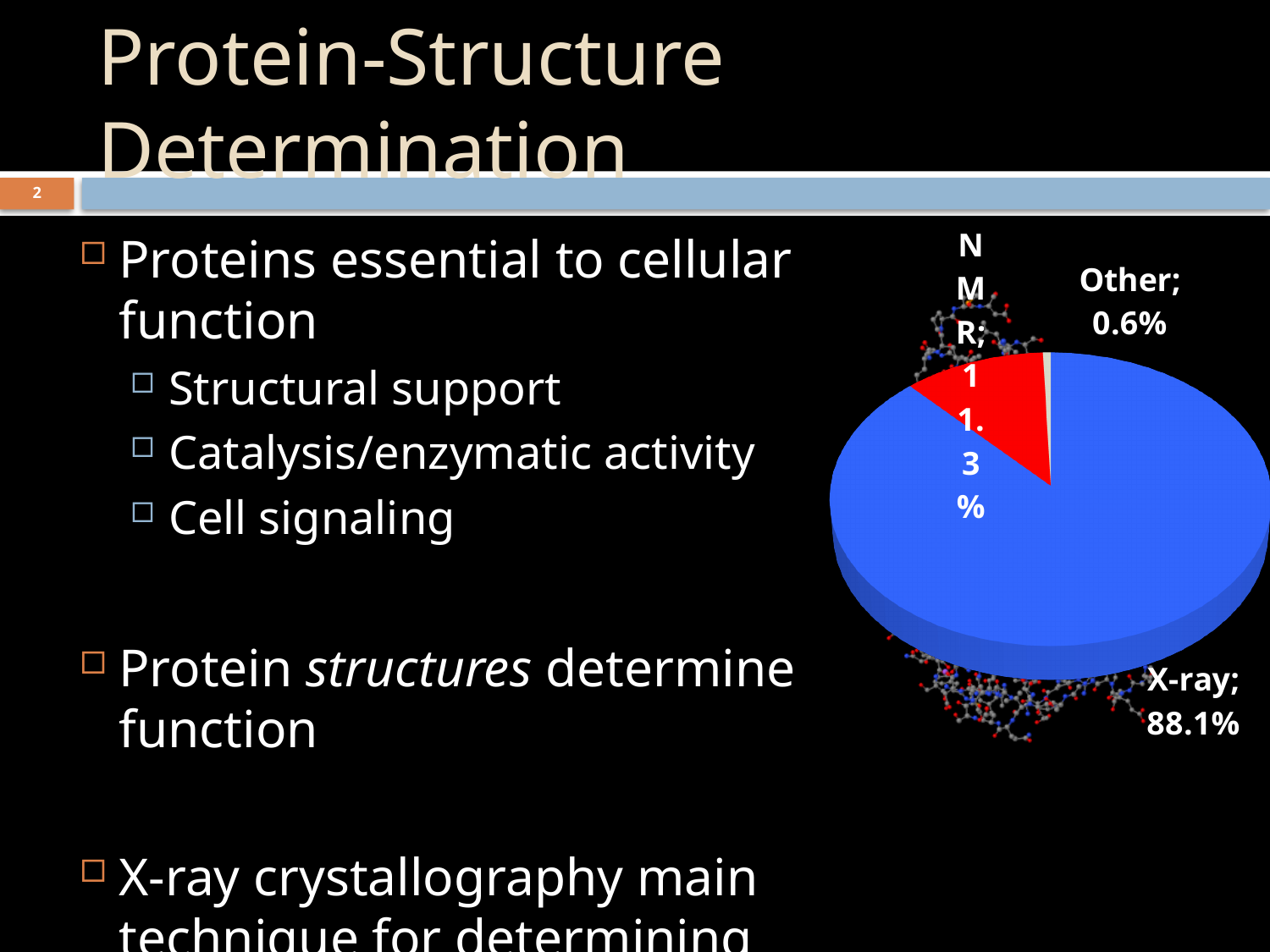
What is the difference in percentage points between the NMR and Other slices? 10.7 Which category has the smallest slice of the pie? Other Which is larger, the NMR slice or the Other slice? NMR How many slices does the pie chart have? 3 What is the difference in percentage points between the X-ray and NMR slices? 76.8 What share of the pie does NMR account for? 11.3% What colour is the NMR slice of the pie chart? red Which category has the largest slice of the pie? X-ray What share of the pie does X-ray account for? 88.1% What share of the pie does Other account for? 0.6% What colour is the X-ray slice of the pie chart? blue What kind of chart is shown on the slide? pie chart